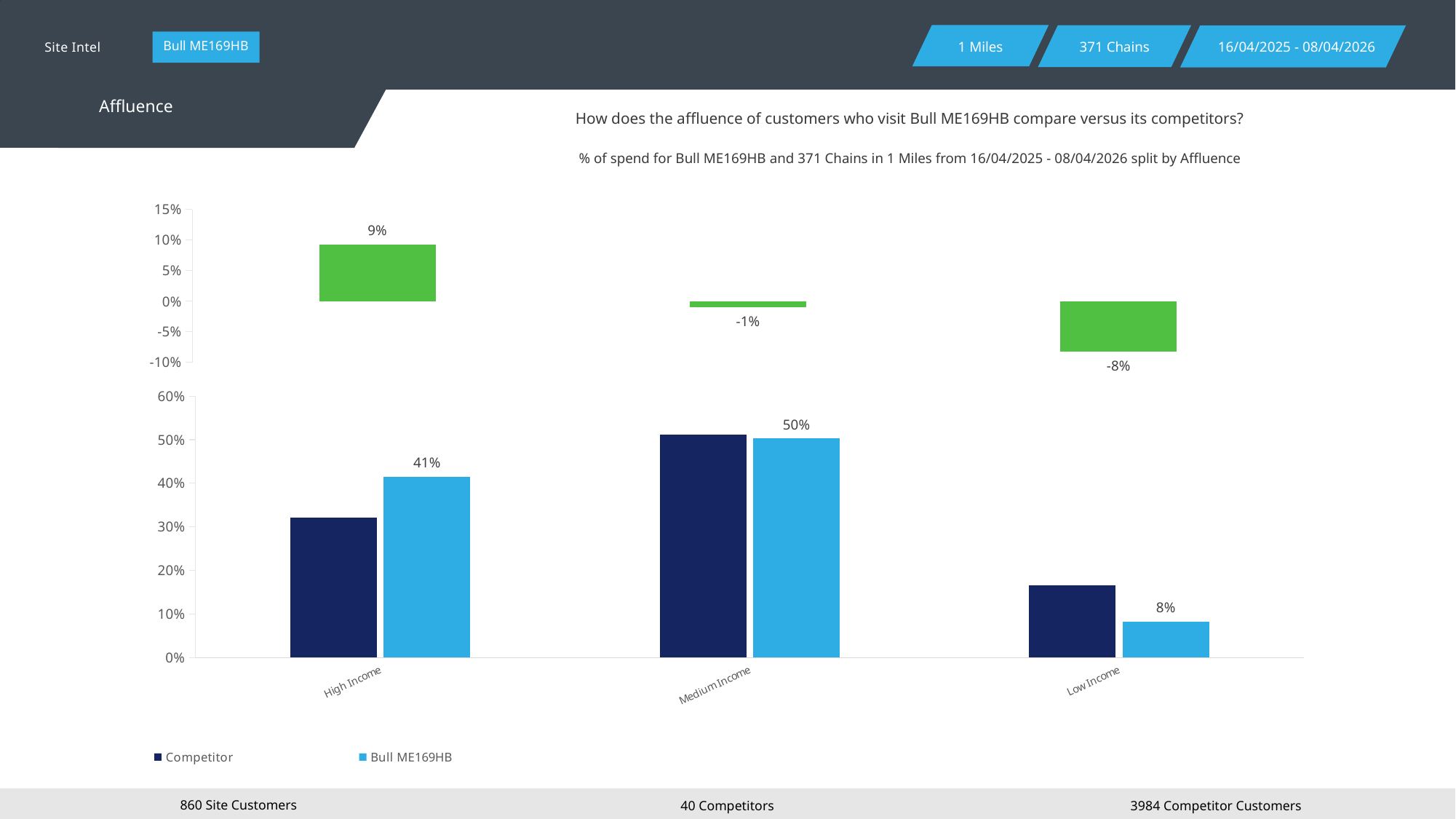
In the bottom chart, what is the value for Bull ME169HB in the High Income category? 41% In the bottom chart, which category has the highest value for Bull ME169HB? Medium Income In the bottom chart, what is the difference between the Bull ME169HB values for Medium Income and Low Income? 42% In the bottom chart, what is the value for Bull ME169HB in the Medium Income category? 50% In the top chart, what is the value shown for the Low Income category? -8% In the top chart, which category has the lowest value? Low Income In the bottom chart, which is larger for High Income: the Competitor value or the Bull ME169HB value? Bull ME169HB In the bottom chart, is the Competitor value for Low Income greater or less than 10%? greater How many series does the legend of the bottom chart list? 2 In the bottom chart, what is the value for Bull ME169HB in the Low Income category? 8% In the top chart, what is the value shown for the High Income category? 9% In the bottom chart, is the Competitor value for High Income greater or less than 40%? less